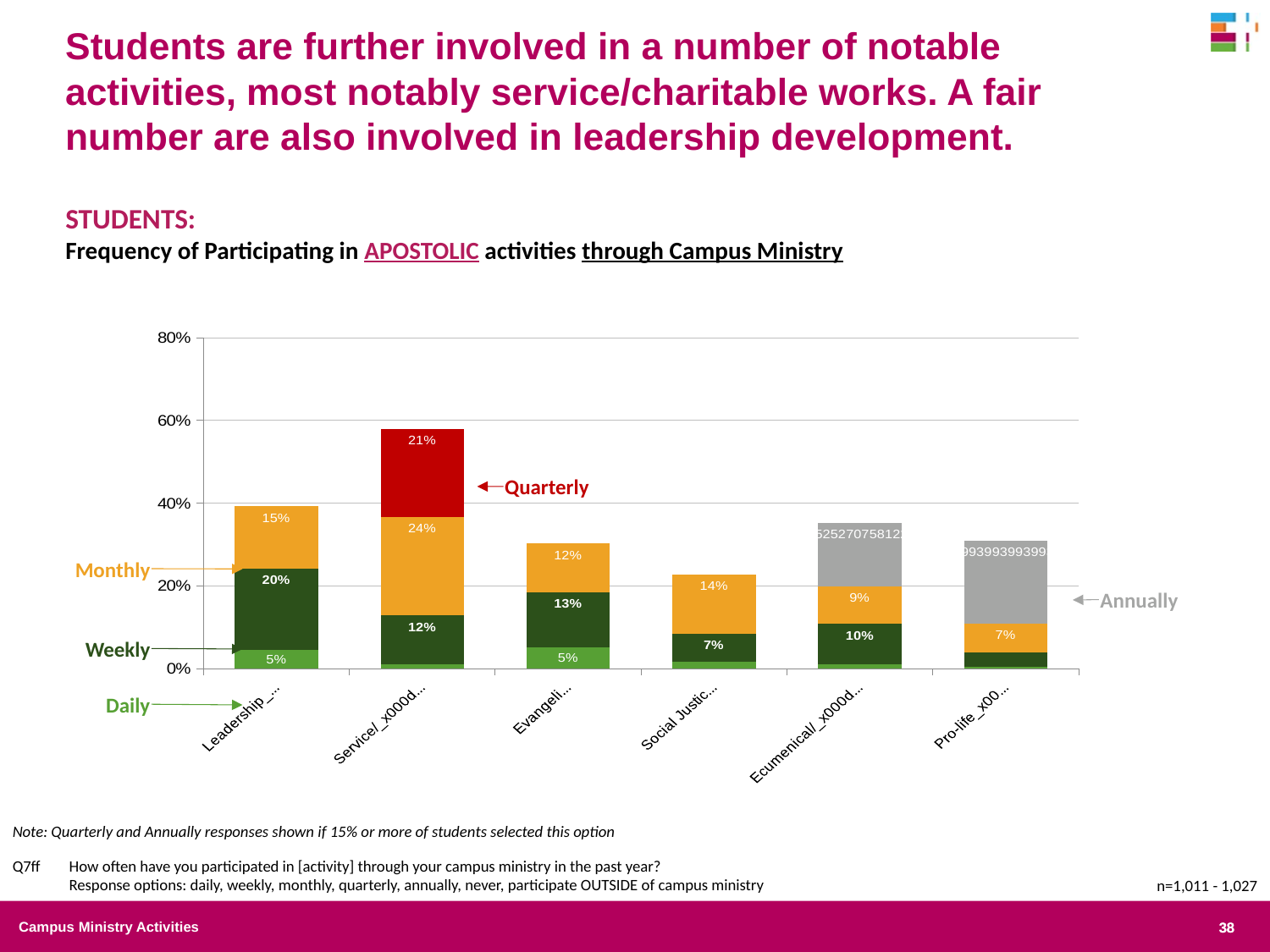
What is the Monthly value for Social Justice? 14% What is the Monthly value for Pro-life? 7% What is the difference between the Weekly value for Leadership and the Weekly value for Social Justice? 13% What kind of chart is shown on the slide? Stacked bar chart What is the Weekly value for Ecumenical? 10% How many activity categories are shown on the x axis? 6 What is the Weekly value for Leadership? 20% Is the total height of the Service bar greater or less than 40%? greater What is the combined total of the Daily, Weekly and Monthly segments for Leadership? 40% Which activity has the tallest stacked bar overall? Service Which is larger, the Monthly value for Service or the Monthly value for Leadership? Service What is the Quarterly value for Service? 21%